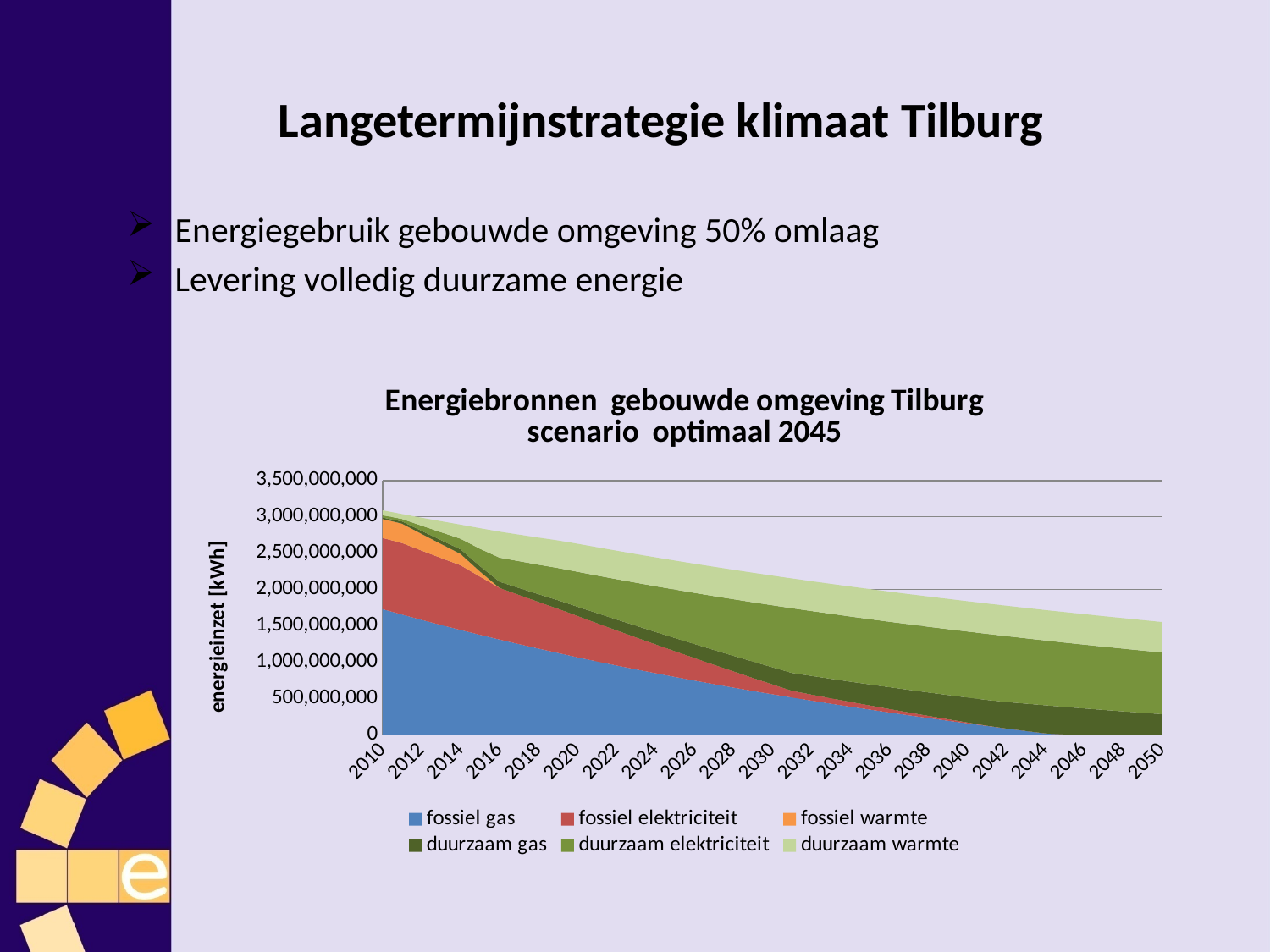
What kind of chart is shown on the slide? area chart Is the value for 'fossiel gas' in 2010 greater or less than 1,500,000,000? greater Does the 'fossiel gas' area rise or fall from 2010 to 2050? fall How many series does the chart legend list? 6 Is the total stacked value in 2040 greater or less than 2,000,000,000? less Is the value for 'fossiel gas' in 2040 greater or less than 500,000,000? less Does the total stacked energy use rise or fall from 2010 to 2050? fall What is the label on the y axis of the chart? energieinzet [kWh] How many year labels are shown along the x axis of the chart? 21 Which series has the largest value in 2010? fossiel gas Which series has the largest value in 2050? duurzaam elektriciteit